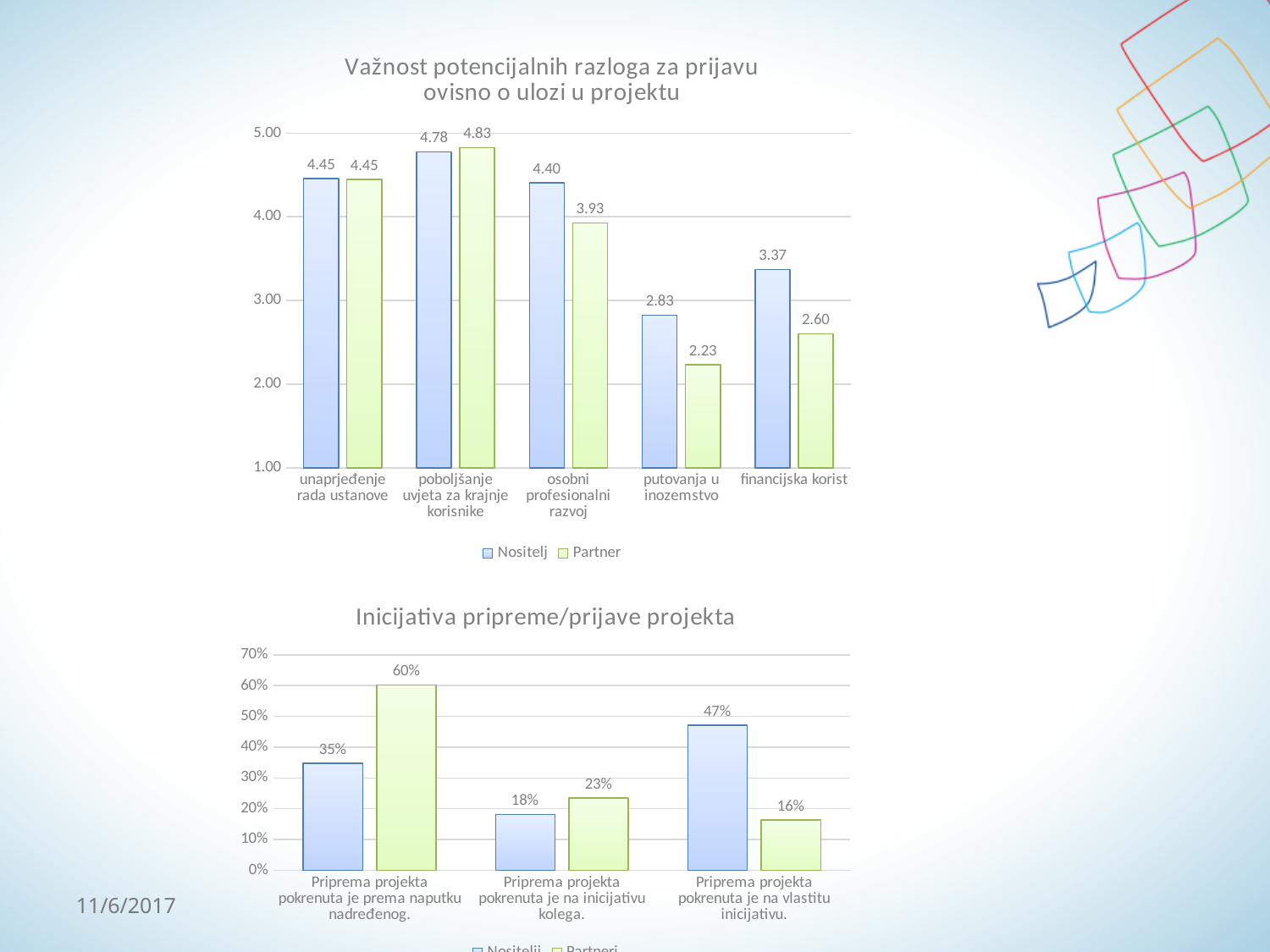
In the top chart, what is the difference between the Nositelj and Partner values for 'financijska korist'? 0.77 In the top chart, which category has the lowest Nositelj value? putovanja u inozemstvo How many series does the legend of the top chart list? 2 In the bottom chart, which category has the lowest blue bar value? Priprema projekta pokrenuta je na inicijativu kolega. How many categories are shown on the x axis of the top chart? 5 In the bottom chart, what is the value of the green bar for 'Priprema projekta pokrenuta je prema naputku nadređenog.'? 60% In the top chart, what is the Partner value for 'putovanja u inozemstvo'? 2.23 In the bottom chart, what is the difference between the blue bar and the green bar for 'Priprema projekta pokrenuta je na vlastitu inicijativu.'? 31% In the top chart, which category has the highest Partner value? poboljšanje uvjeta za krajnje korisnike In the top chart, for 'osobni profesionalni razvoj', which is larger: the Nositelj value or the Partner value? Nositelj What type of chart is the bottom chart titled 'Inicijativa pripreme/prijave projekta'? bar chart In the top chart, what is the Nositelj value for 'osobni profesionalni razvoj'? 4.40